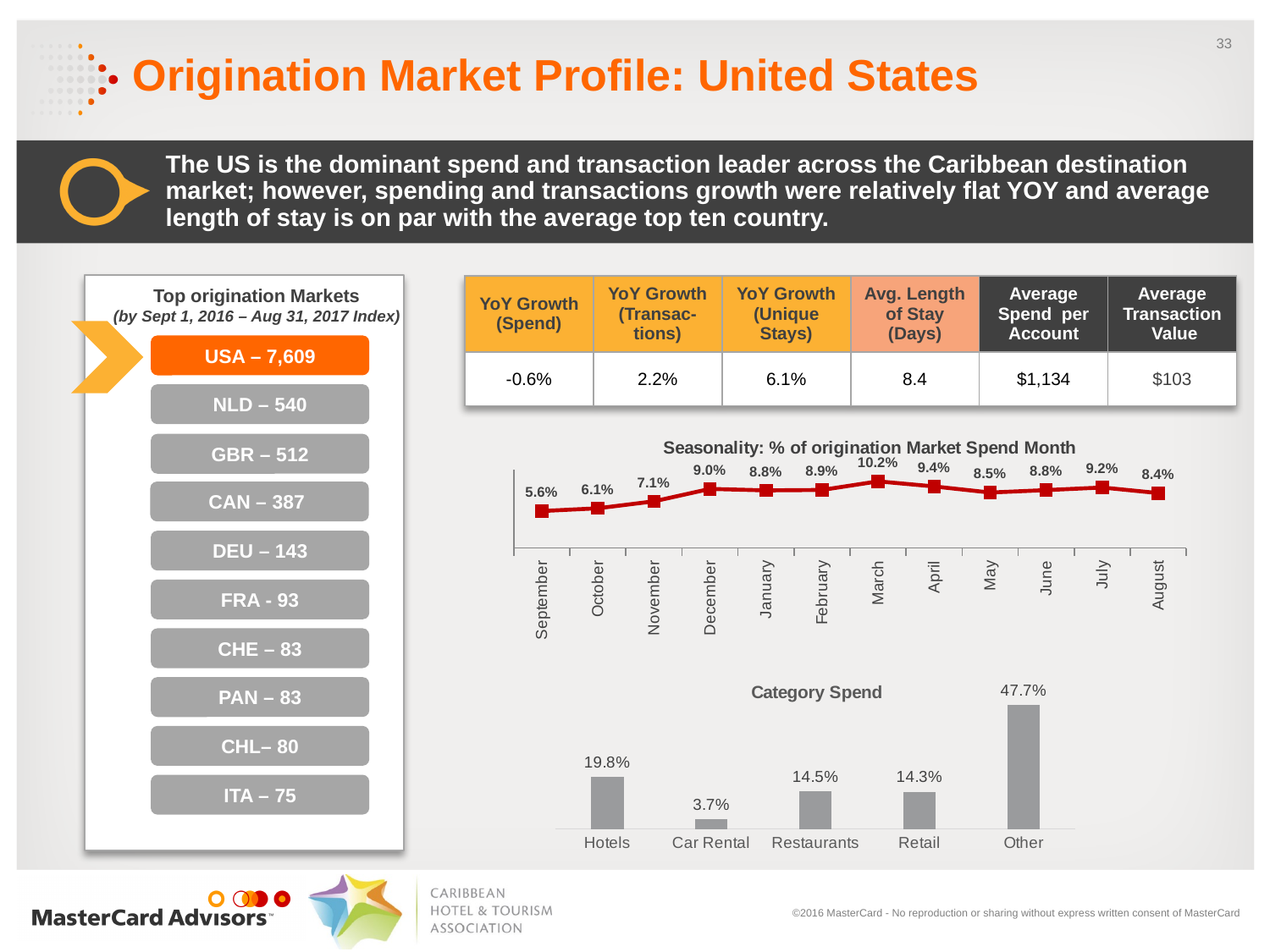
In the Seasonality chart, what is the value for March? 10.2% In the Category Spend chart, what is the value for Hotels? 19.8% In the Seasonality chart, do the values rise or fall from September to December? Rise In the Seasonality chart, which month has the highest value? March In the Seasonality chart, what is the value for September? 5.6% In the Category Spend chart, which category has the lowest value? Car Rental In the Category Spend chart, what is the difference between Other and Hotels? 27.9% What kind of chart is the Seasonality chart? Line chart In the Seasonality chart, what is the difference between the values for March and September? 4.6% In the Seasonality chart, how many months are plotted? 12 In the Seasonality chart, which month has the lowest value? September What kind of chart is the Category Spend chart? Bar chart